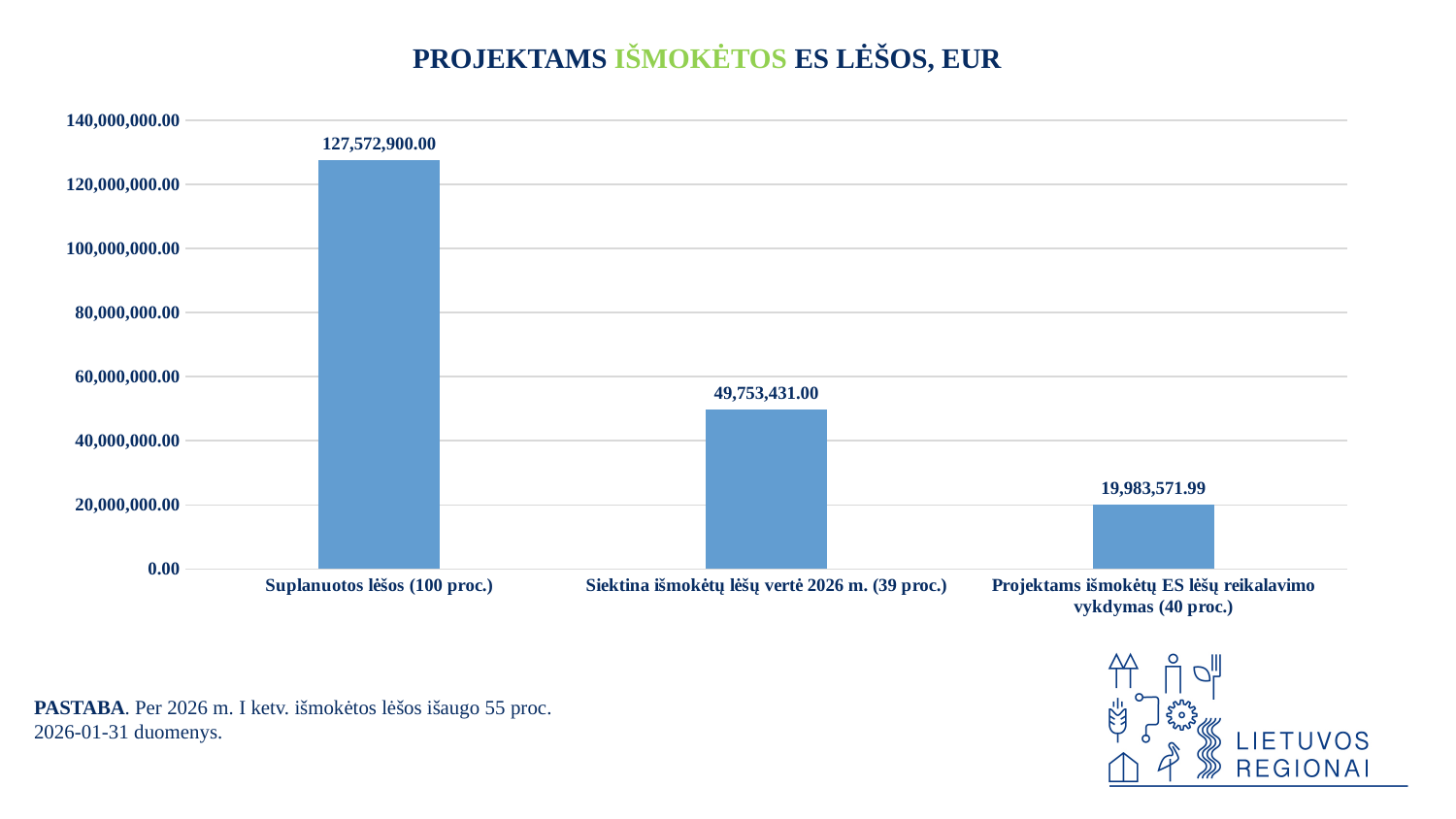
Which is larger: the value for "Siektina išmokėtų lėšų vertė 2026 m. (39 proc.)" or the value for "Projektams išmokėtų ES lėšų reikalavimo vykdymas (40 proc.)"? Siektina išmokėtų lėšų vertė 2026 m. (39 proc.) How many categories are shown in the chart? 3 What is the title of the chart? PROJEKTAMS IŠMOKĖTOS ES LĖŠOS, EUR What is the value for "Siektina išmokėtų lėšų vertė 2026 m. (39 proc.)"? 49,753,431.00 What is the difference between the values for "Siektina išmokėtų lėšų vertė 2026 m. (39 proc.)" and "Projektams išmokėtų ES lėšų reikalavimo vykdymas (40 proc.)"? 29,769,859.01 Is the value for "Siektina išmokėtų lėšų vertė 2026 m. (39 proc.)" greater or less than 40,000,000.00? greater Which category has the highest value? Suplanuotos lėšos (100 proc.) What is the value for "Projektams išmokėtų ES lėšų reikalavimo vykdymas (40 proc.)"? 19,983,571.99 Which category has the lowest value? Projektams išmokėtų ES lėšų reikalavimo vykdymas (40 proc.) What is the difference between the values for "Suplanuotos lėšos (100 proc.)" and "Siektina išmokėtų lėšų vertė 2026 m. (39 proc.)"? 77,819,469.00 What kind of chart is shown on the slide? bar chart What is the value for "Suplanuotos lėšos (100 proc.)"? 127,572,900.00